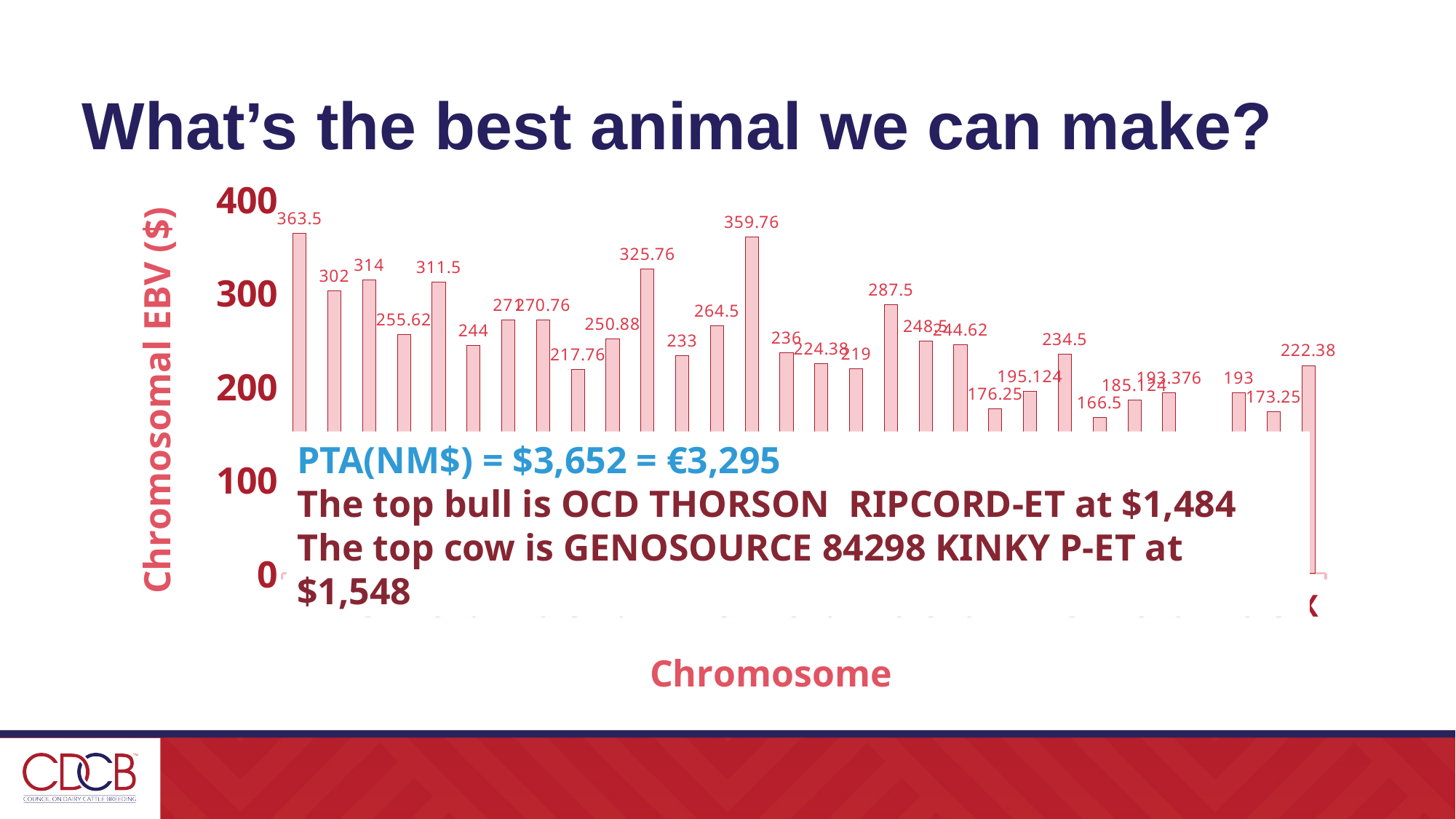
What is the label of the y-axis? Chromosomal EBV ($) What is the difference between the highest bar (363.5) and the lowest bar (166.5)? 197 Which is larger, the bar labelled 325.76 or the bar labelled 311.5? 325.76 What is the difference between the first bar (363.5) and the second bar (302)? 61.5 What is the lowest chromosomal EBV value labelled in the chart? 166.5 What kind of chart is shown on the slide? bar chart Is the value of the rightmost bar (222.38) greater or less than 200? greater What is the value of the leftmost bar in the chart? 363.5 Which is larger, the bar labelled 359.76 or the bar labelled 363.5? 363.5 What is the highest chromosomal EBV value shown in the chart? 363.5 What is the label of the x-axis? Chromosome What is the highest tick value shown on the y-axis? 400